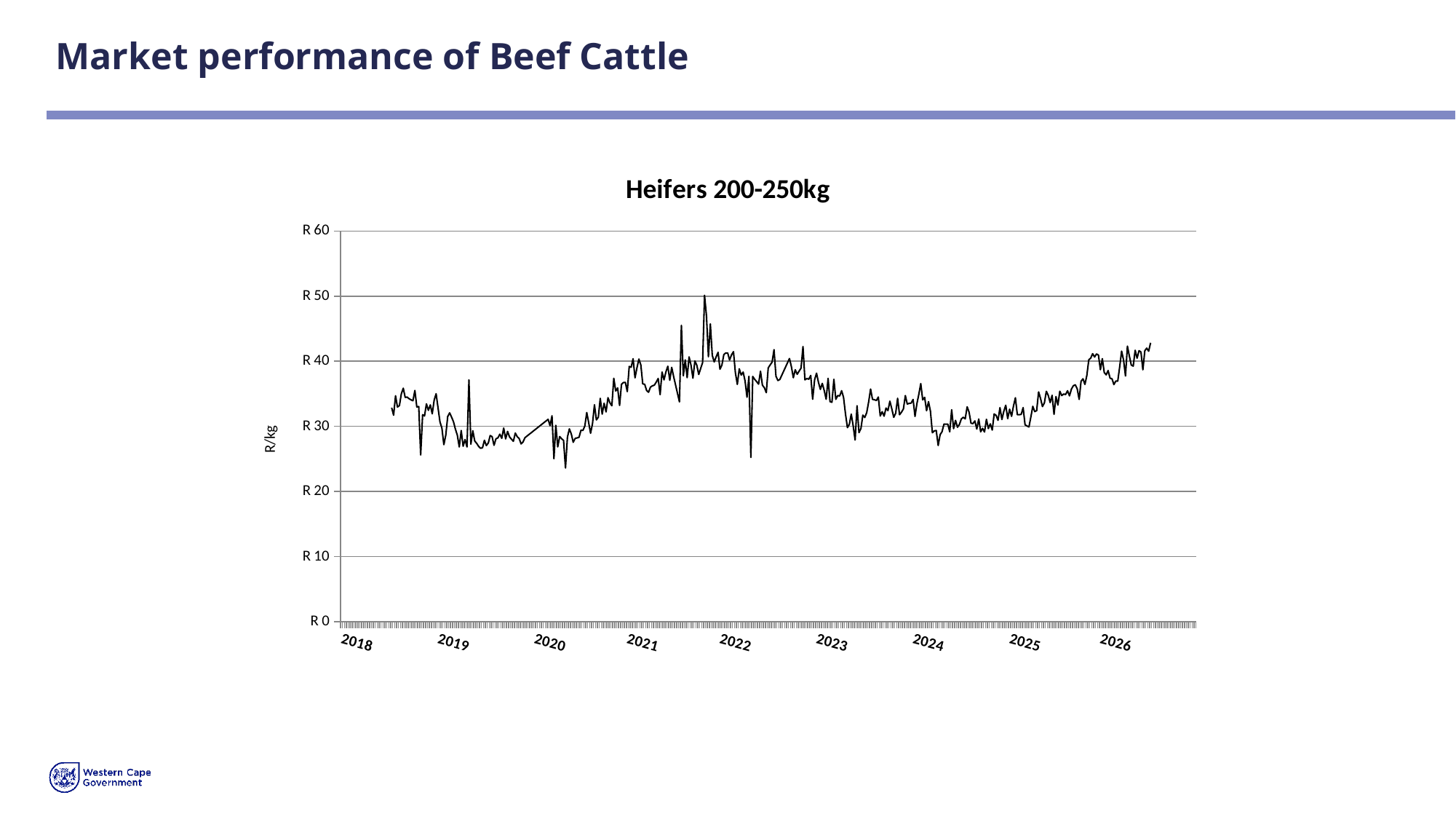
Is the highest peak of the line greater or less than R 40? greater What is the highest value shown on the vertical axis? R 60 What is the title of the chart? Heifers 200-250kg How many lines are plotted on the chart? 1 Is the value at the end of the line, in 2026, greater or less than R 40? greater Is the lowest point of the line, around 2020, greater or less than R 30? less Does the line rise or fall between 2024 and 2026? rise How many year labels are shown along the x axis? 9 What kind of chart is shown on the slide? line chart Does the line rise or fall between 2022 and 2024? fall What is the label on the vertical axis of the chart? R/kg